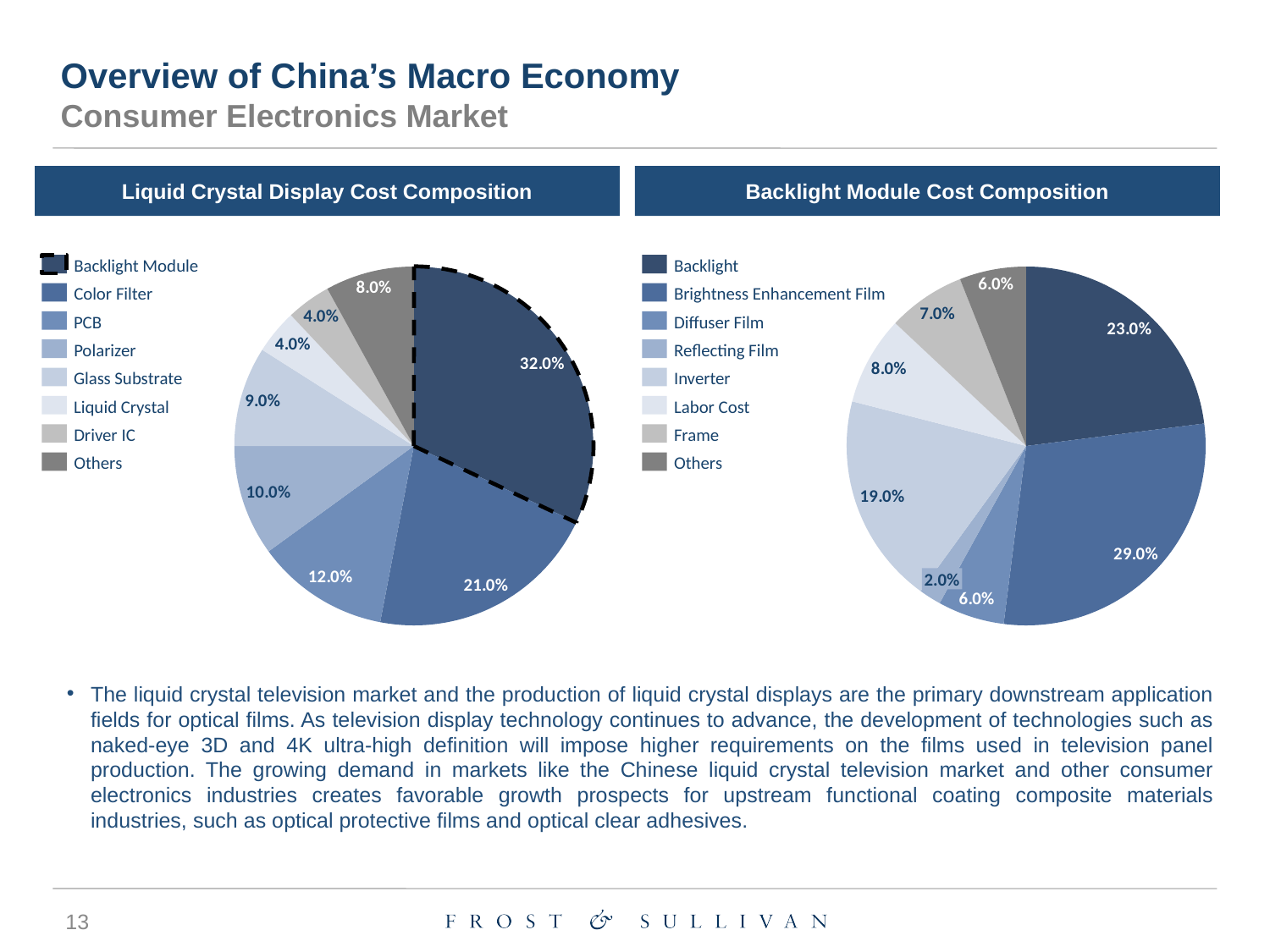
In the Liquid Crystal Display Cost Composition chart, what is the difference between the PCB share and the Polarizer share? 2.0% In the Backlight Module Cost Composition chart, what share does Inverter account for? 19.0% In the Backlight Module Cost Composition chart, what is the difference between the Labor Cost share and the Frame share? 1.0% In the Backlight Module Cost Composition chart, which is larger, Backlight or Brightness Enhancement Film? Brightness Enhancement Film In the Backlight Module Cost Composition chart, what is the value for Brightness Enhancement Film? 29.0% In the Liquid Crystal Display Cost Composition chart, what is the value for Color Filter? 21.0% What type of chart is used for the Backlight Module Cost Composition? Pie chart In the Backlight Module Cost Composition chart, which component has the smallest share? Reflecting Film In the Liquid Crystal Display Cost Composition chart, which slice is outlined with a dashed border? Backlight Module In the Liquid Crystal Display Cost Composition chart, how many categories does the legend list? 8 In the Liquid Crystal Display Cost Composition chart, which component has the largest share? Backlight Module In the Liquid Crystal Display Cost Composition chart, what share does Backlight Module account for? 32.0%